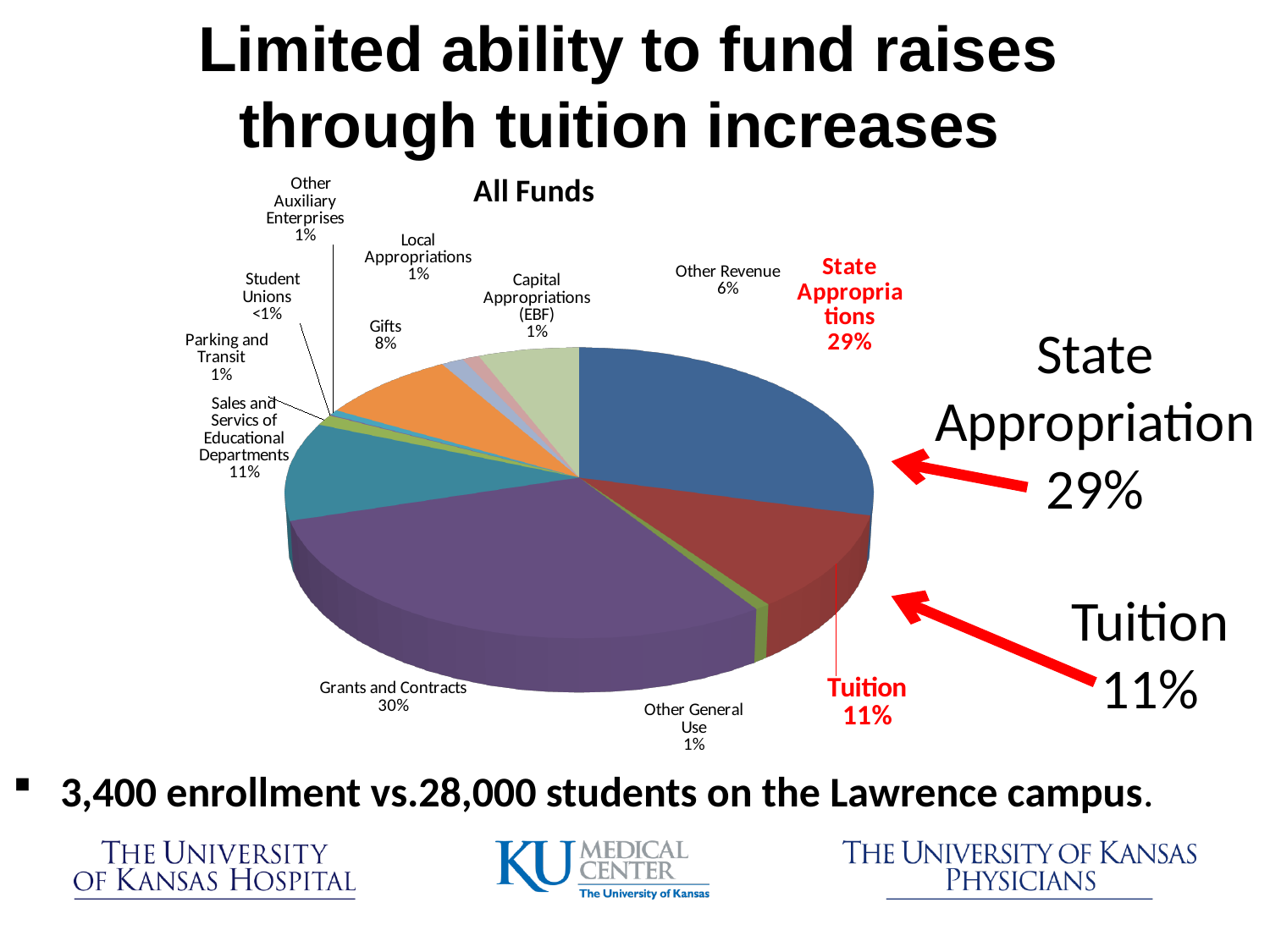
What share of All Funds comes from Other Revenue? 6% What is the difference in percentage points between State Appropriations and Tuition? 18 What share of All Funds comes from Gifts? 8% How many categories are shown in the All Funds pie chart? 12 What share of All Funds comes from Tuition? 11% Which is larger, the share for Gifts or the share for Other Revenue? Gifts What share of All Funds comes from State Appropriations? 29% What type of chart is shown on the slide? pie chart Which category has the smallest share of All Funds? Student Unions Which category has the largest share of All Funds? Grants and Contracts What share of All Funds comes from Grants and Contracts? 30% What is the title of the chart? All Funds